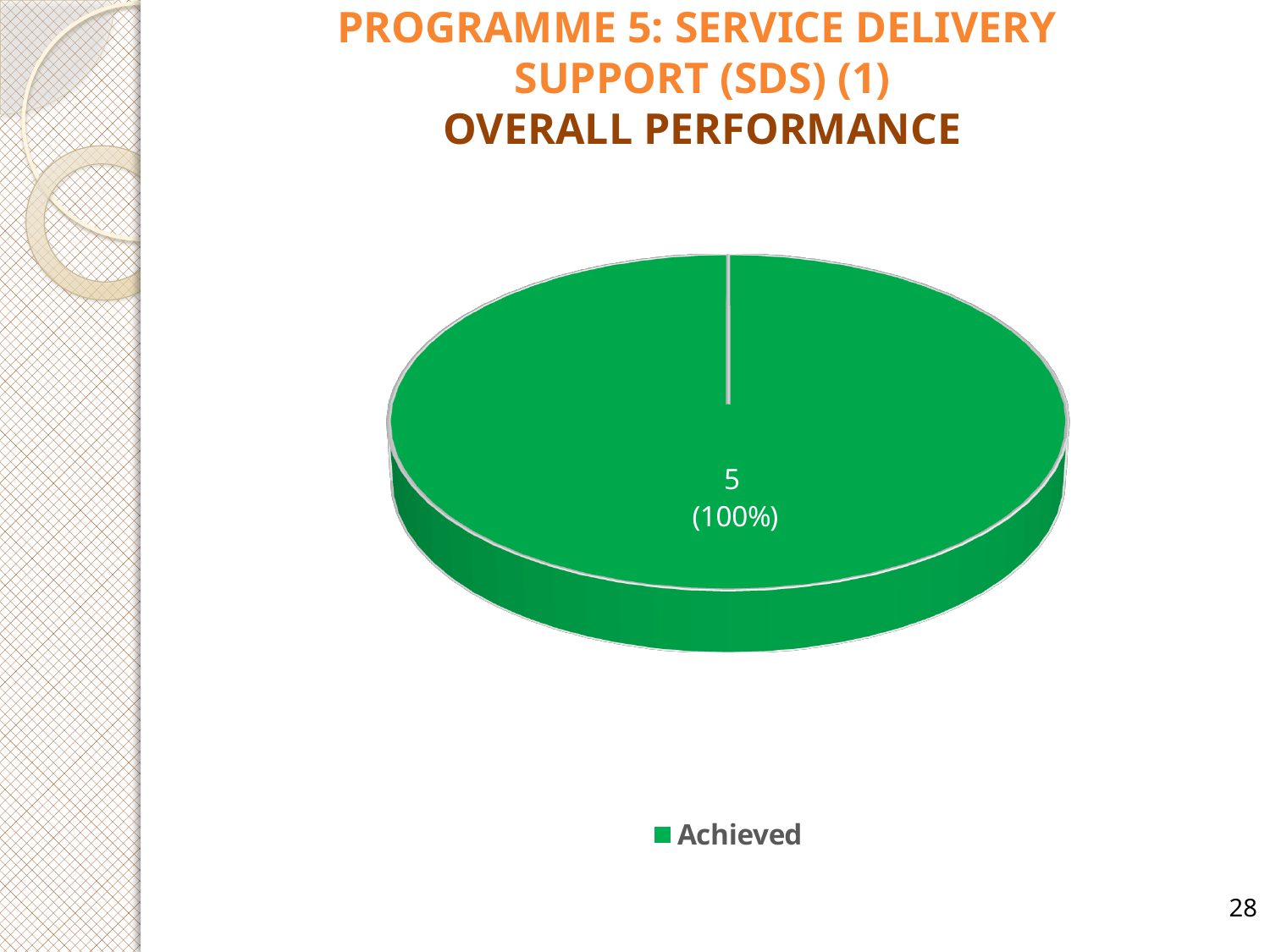
What kind of chart is shown on the slide? Pie chart What is the value shown for the Achieved slice? 5 How many slices does the pie chart have? 1 What is the only legend entry on the chart? Achieved Is the value for Achieved greater or less than 3? greater What colour is the Achieved slice? Green What share of the pie does the Achieved slice represent? 100% How many series does the legend list? 1